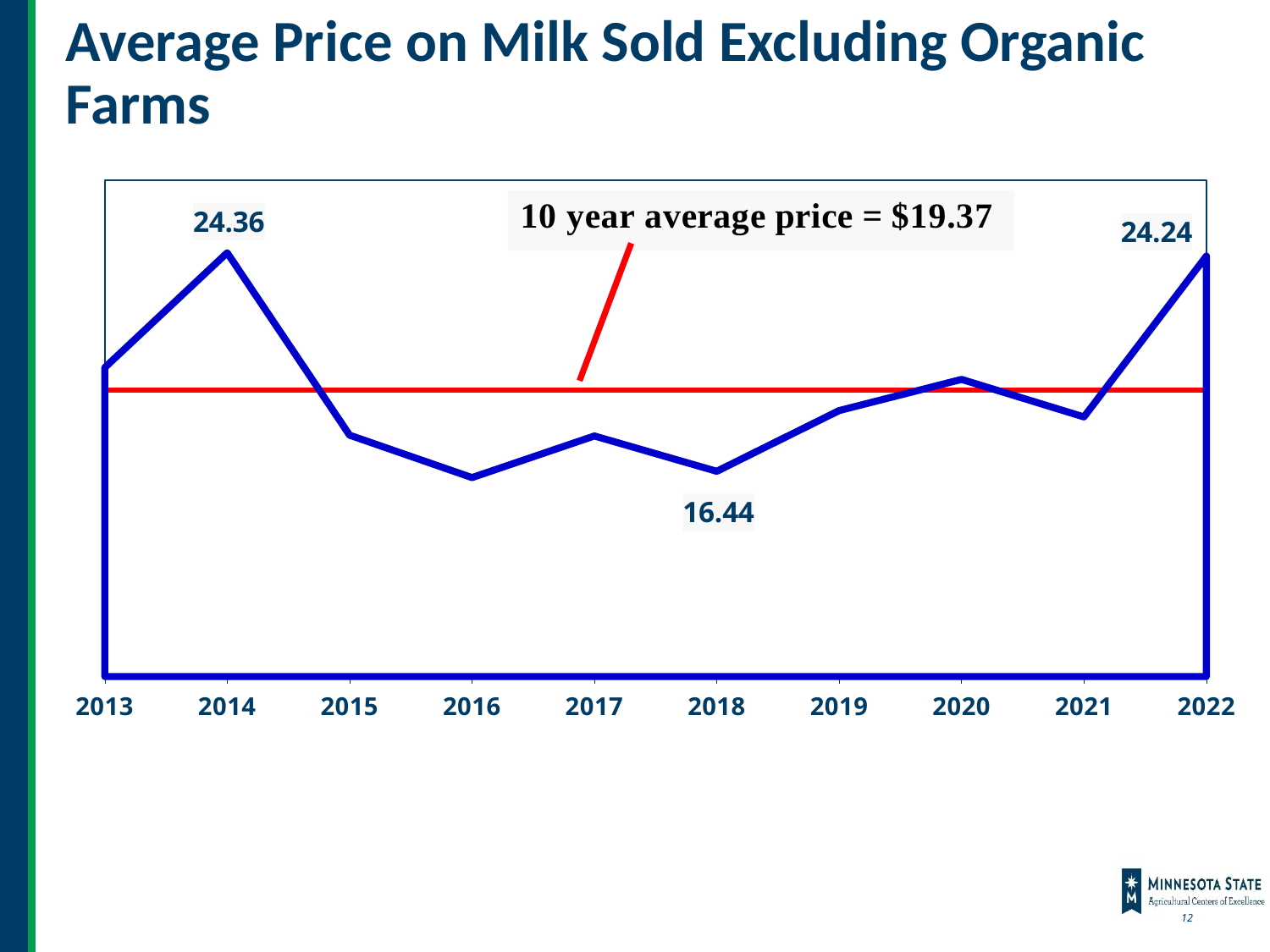
Do the values rise or fall from 2018 to 2020? rise What kind of chart is shown on the slide? Line chart What is the average milk price shown for 2022? 24.24 What is the 10 year average price stated on the chart? $19.37 What is the average milk price shown for 2014? 24.36 Is the value for 2016 greater or less than the 10 year average price of $19.37? less What is the difference between the 2014 price and the 2018 price? 7.92 Which year has the lowest average milk price? 2016 Which year has the highest average milk price? 2014 Which year has the higher price, 2014 or 2022? 2014 How many years are plotted on the x axis? 10 What is the average milk price shown for 2018? 16.44